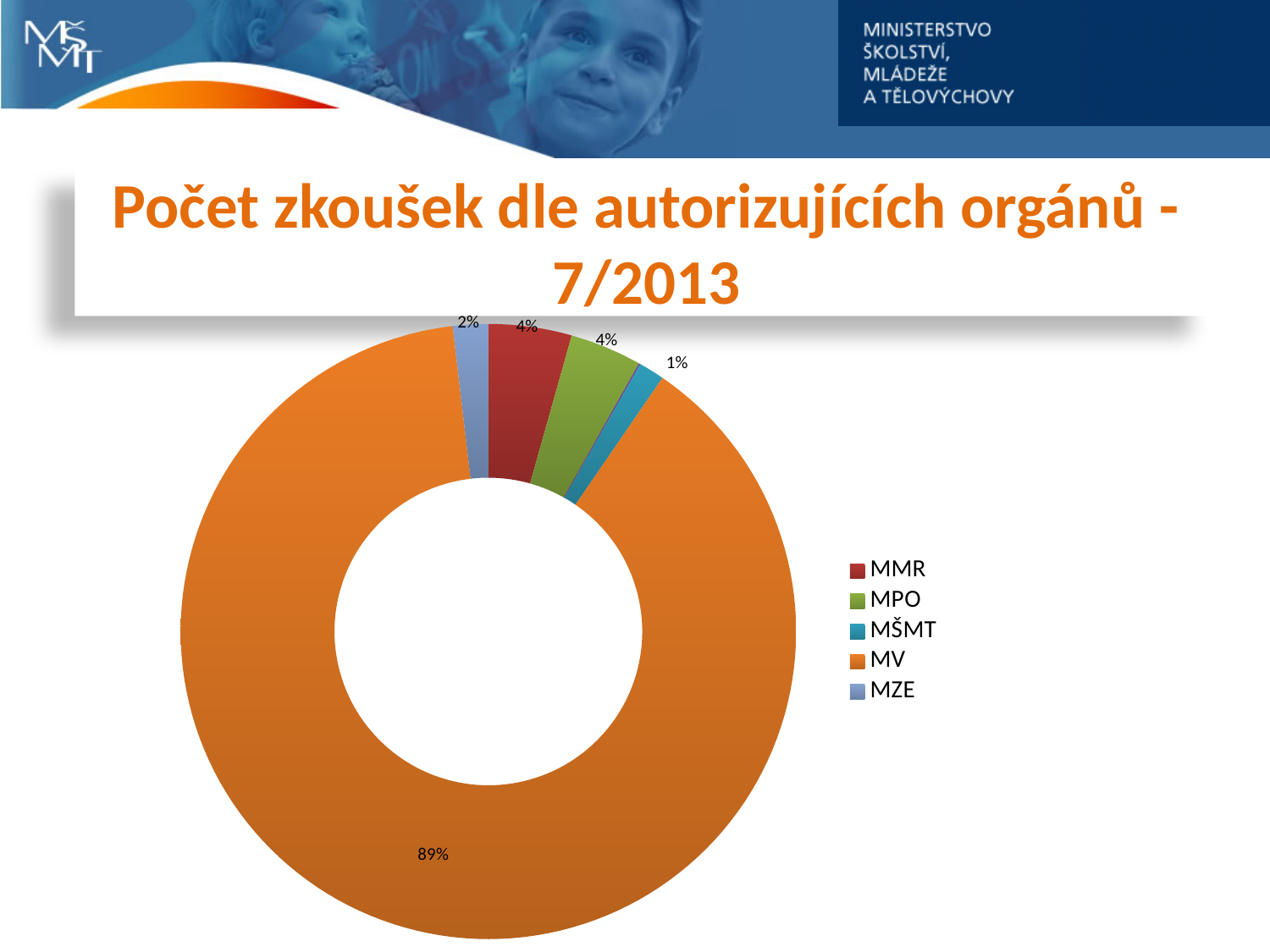
What percentage is shown for MZE? 2% What percentage is shown for MPO? 4% What kind of chart is shown on the slide? Doughnut (pie) chart Which authorizing body has the smallest share of exams? MŠMT What percentage is shown for MMR? 4% What percentage is shown for MŠMT? 1% Which authorizing body has the largest share of exams? MV How many categories does the legend list? 5 What colour represents MV in the chart? Orange Which has the larger share, MZE or MŠMT? MZE By how many percentage points does MV's share exceed MZE's share? 87 percentage points What share of the chart does MV account for? 89%